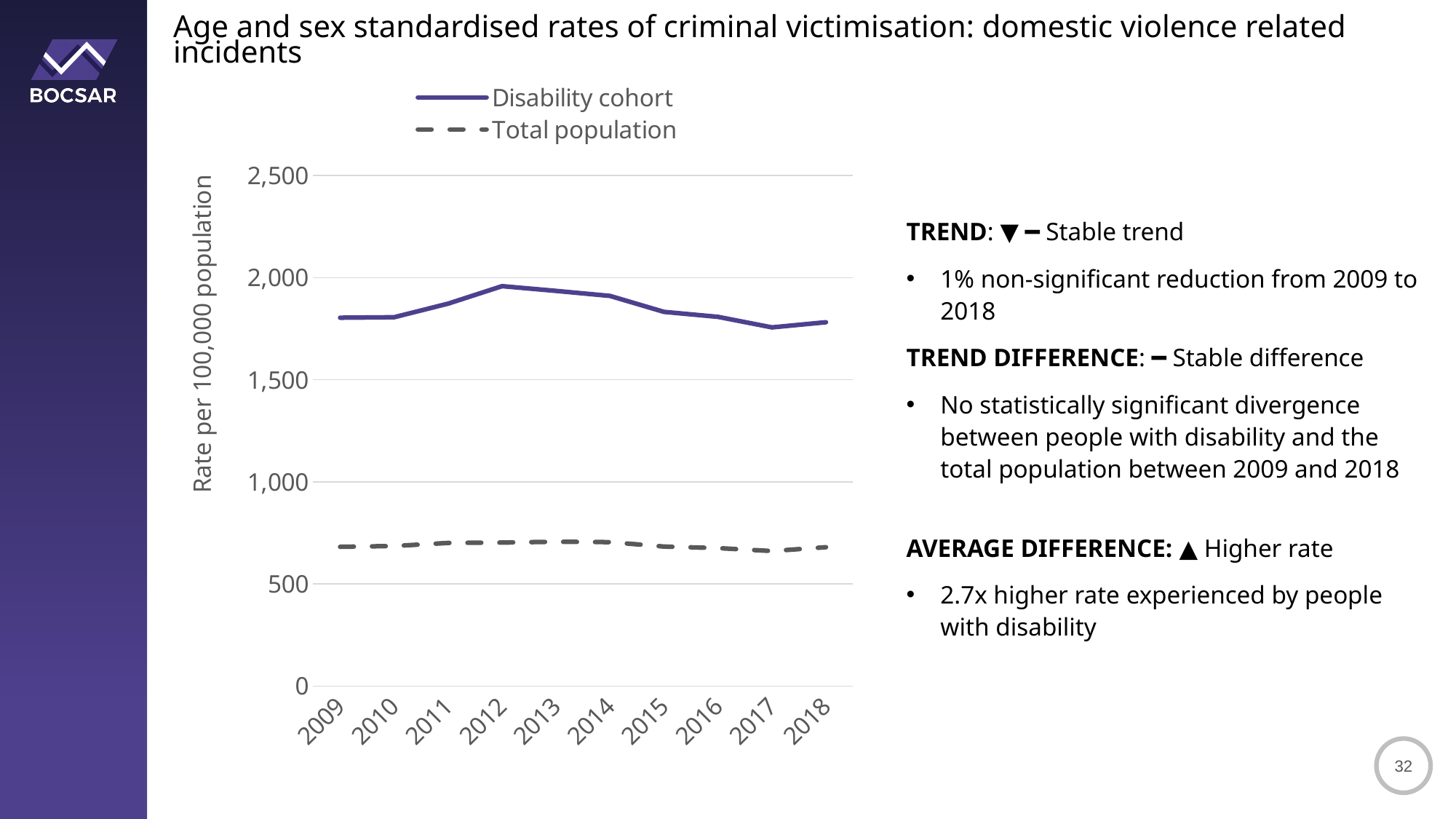
Which series is drawn with a dashed line? Total population How many series does the legend list? 2 Is the value for the Disability cohort in 2012 greater or less than 1,500? greater Is the value for the Total population in 2013 greater or less than 1,000? less What is the label on the y axis? Rate per 100,000 population How many years are plotted along the x axis? 10 What kind of chart is shown on the slide? Line chart Does the Disability cohort line end in 2018 higher or lower than it started in 2009? Lower Is the value for the Total population in 2018 greater or less than 500? greater In which year does the Disability cohort line reach its highest value? 2012 In 2015, which series has the higher rate: Disability cohort or Total population? Disability cohort